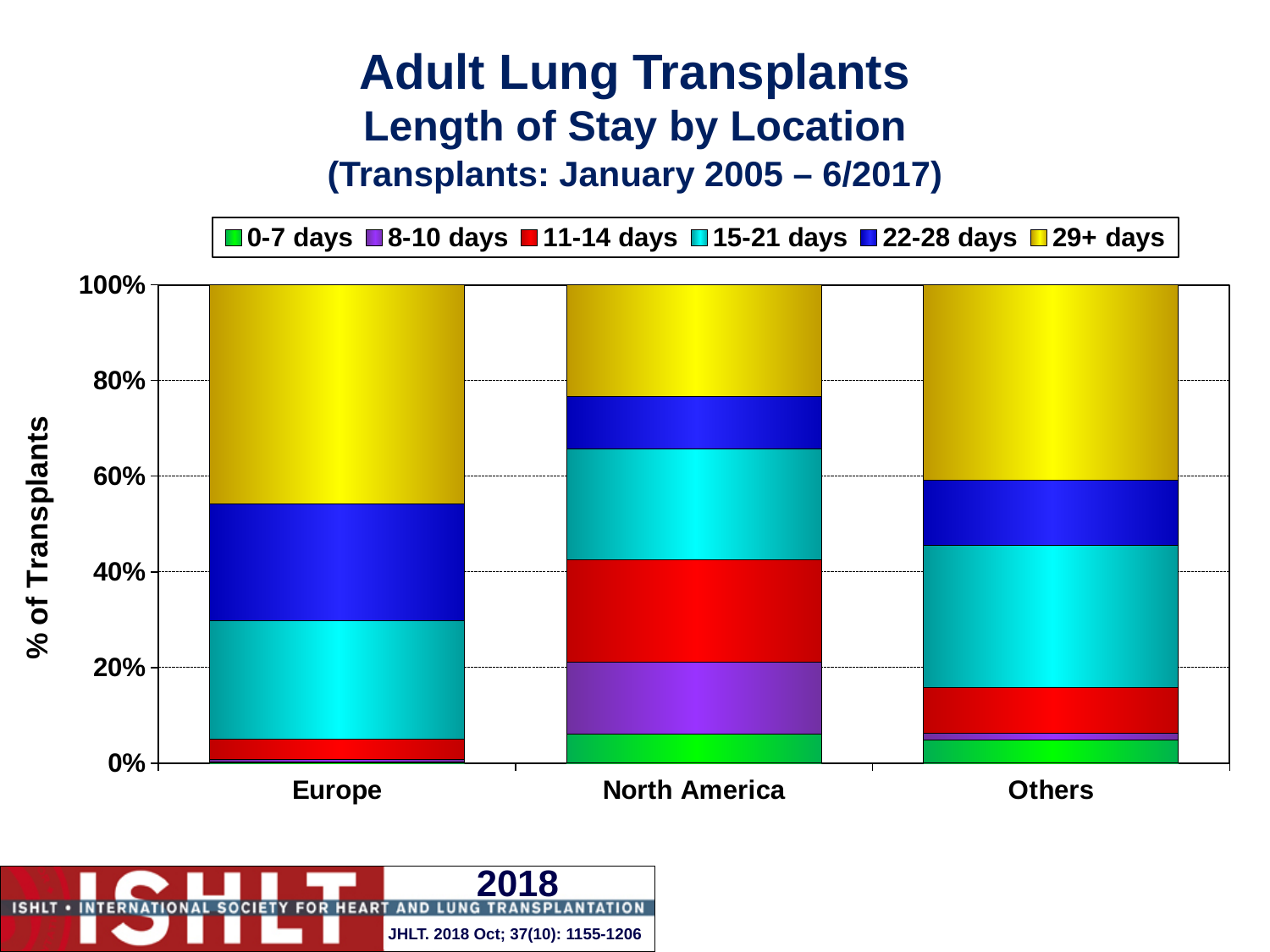
What is the label on the y axis? % of Transplants Is the 29+ days share for Europe greater or less than 40%? greater Which location has the larger 29+ days share, Europe or North America? Europe Is the 15-21 days share for Others greater or less than 20%? greater Which location has the smallest 0-7 days share? Europe What is the total height of each stacked bar? 100% Which location has the largest 8-10 days share? North America Is the 29+ days share for North America greater or less than 40%? less How many locations are shown on the x axis? 3 How many length-of-stay categories does the legend list? 6 Which location has the larger 11-14 days share, Europe or North America? North America What kind of chart is shown on the slide? Stacked bar chart